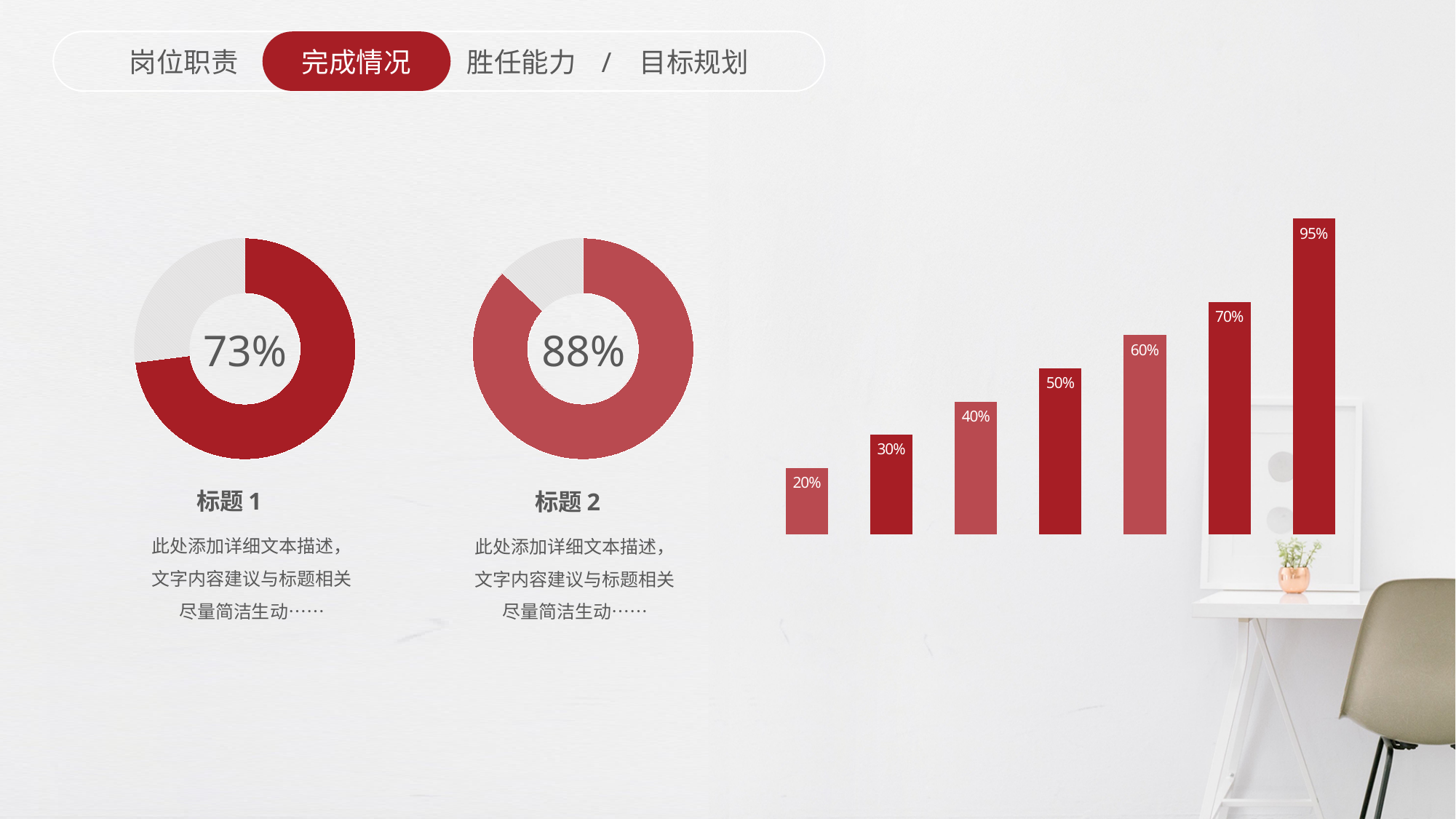
Which of the two donut charts shows the larger value, 标题 1 or 标题 2? 标题 2 What value is shown in the centre of the donut chart labelled 标题 1? 73% What is the difference between the values of the 标题 2 donut chart and the 标题 1 donut chart? 15% In the bar chart on the right, what is the value of the fourth bar from the left? 50% In the bar chart on the right, what is the value of the tallest bar? 95% In the bar chart on the right, what is the difference between the rightmost bar and the bar immediately to its left? 25% What kind of charts are the two charts on the left side of the slide? Donut charts In the bar chart on the right, do the values rise or fall from left to right? Rise What kind of chart is shown on the right side of the slide? Bar chart What value is shown in the centre of the donut chart labelled 标题 2? 88% In the bar chart on the right, what is the value of the shortest bar? 20% In the bar chart on the right, how many bars are there? 7